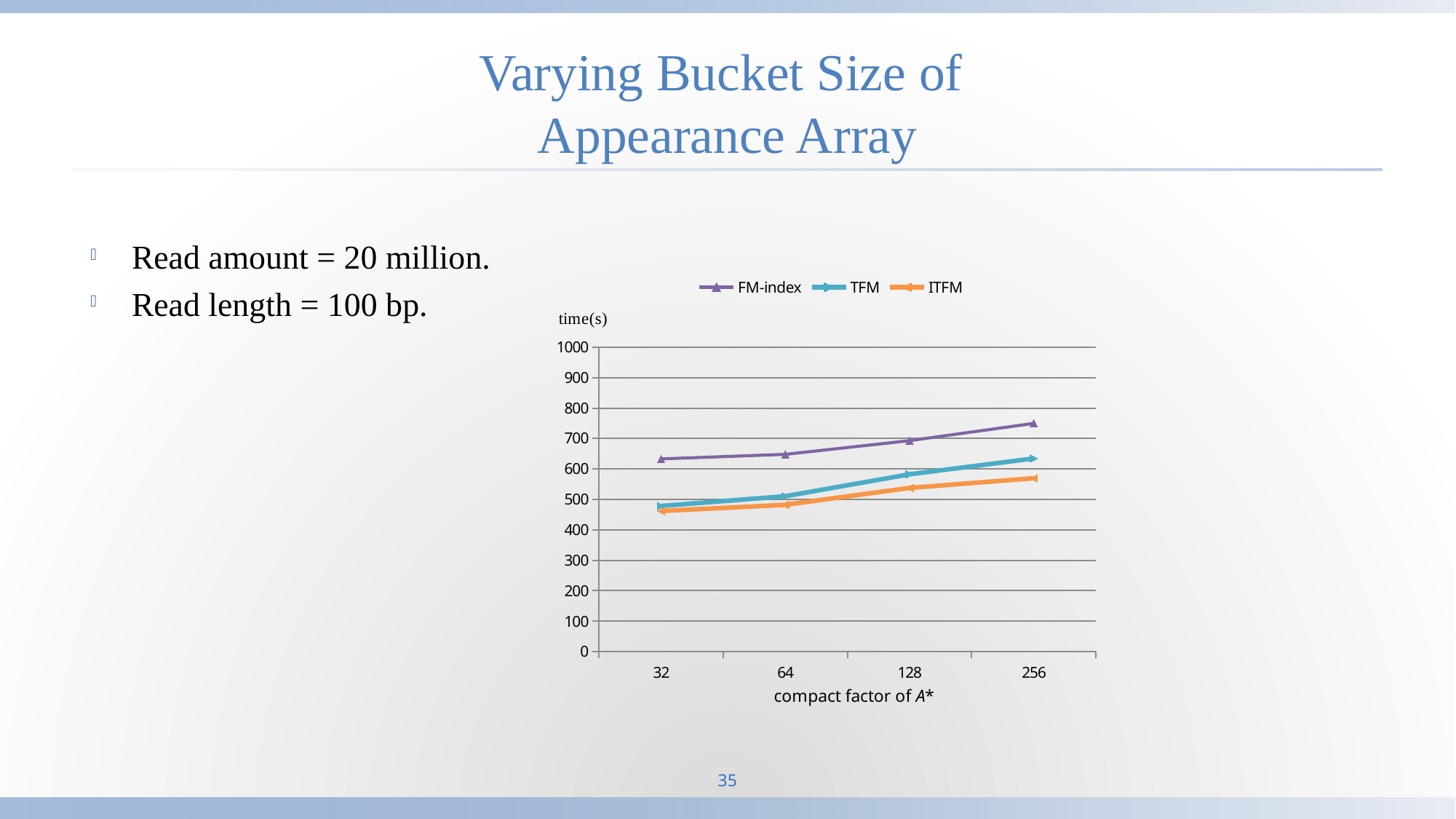
How many compact factor values are plotted along the x axis? 4 Is the ITFM value at compact factor 32 greater or less than 500? less Is the FM-index value at compact factor 256 greater or less than 700? greater Which series has the highest time at compact factor 256? FM-index Which series has the lowest time at compact factor 32? ITFM Do the FM-index values rise or fall as the compact factor increases from 32 to 256? rise Is the TFM value at compact factor 256 greater or less than 600? greater What kind of chart is shown on the slide? line chart What is the label of the x axis? compact factor of A* How many series does the legend list? 3 At compact factor 128, which is larger: the TFM value or the ITFM value? TFM